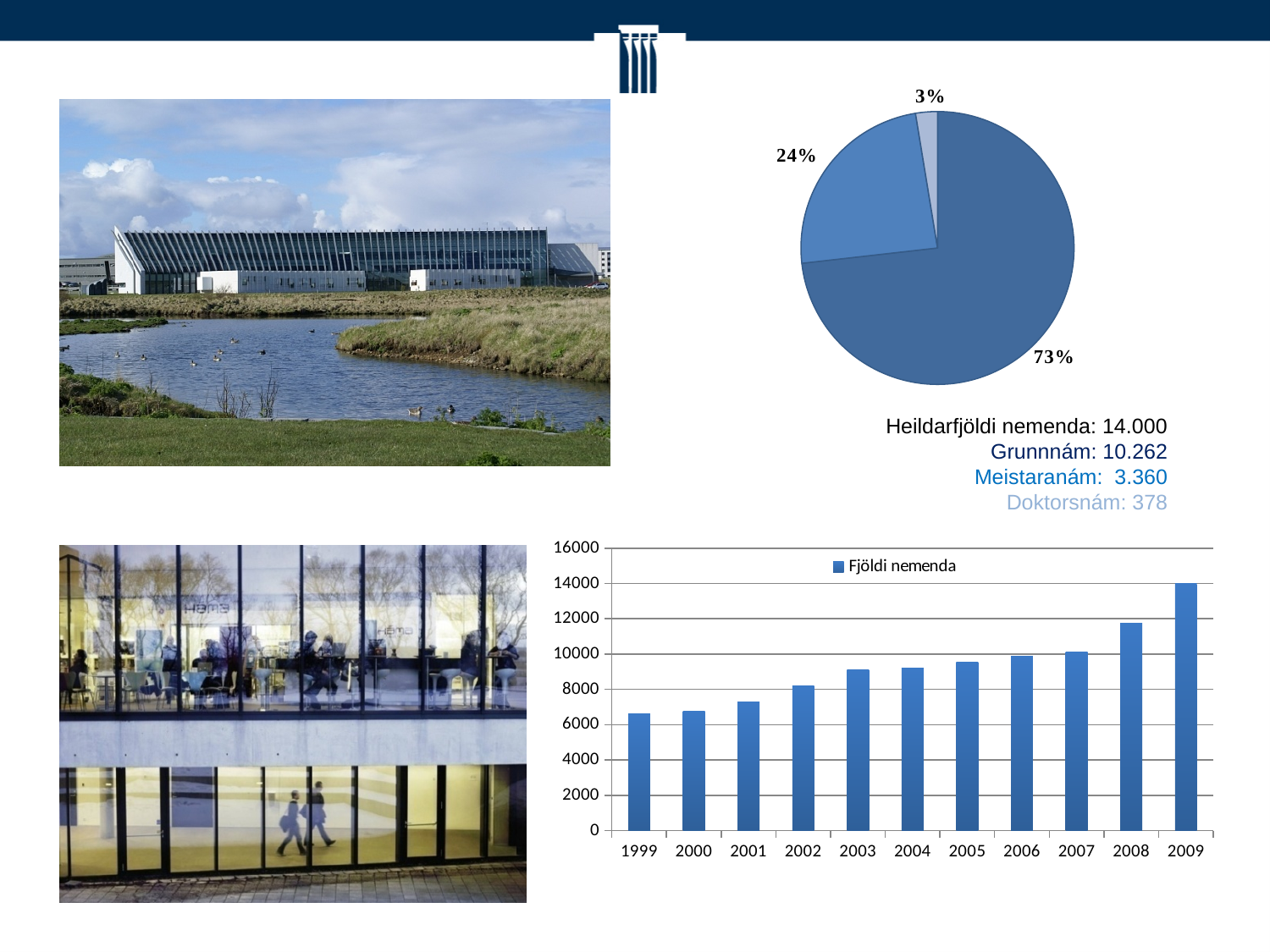
How many slices does the pie chart have? 3 In the bar chart at the bottom right, is the value for 1999 greater or less than 8000? less What kind of chart is the chart at the bottom right of the slide? bar chart In the bar chart at the bottom right, which year has the highest value? 2009 In the bar chart at the bottom right, how many years are shown on the x axis? 11 In the bar chart at the bottom right, do the values generally rise or fall from 1999 to 2009? rise In the bar chart at the bottom right, is the value for 2009 greater or less than 12000? greater In the pie chart, what share does the smallest slice have? 3% What kind of chart is the chart in the top right of the slide? pie chart In the pie chart, what is the difference in percentage points between the largest slice and the second-largest slice? 49 In the pie chart, what share does the largest slice have? 73% How many series does the legend of the bar chart at the bottom right list? 1